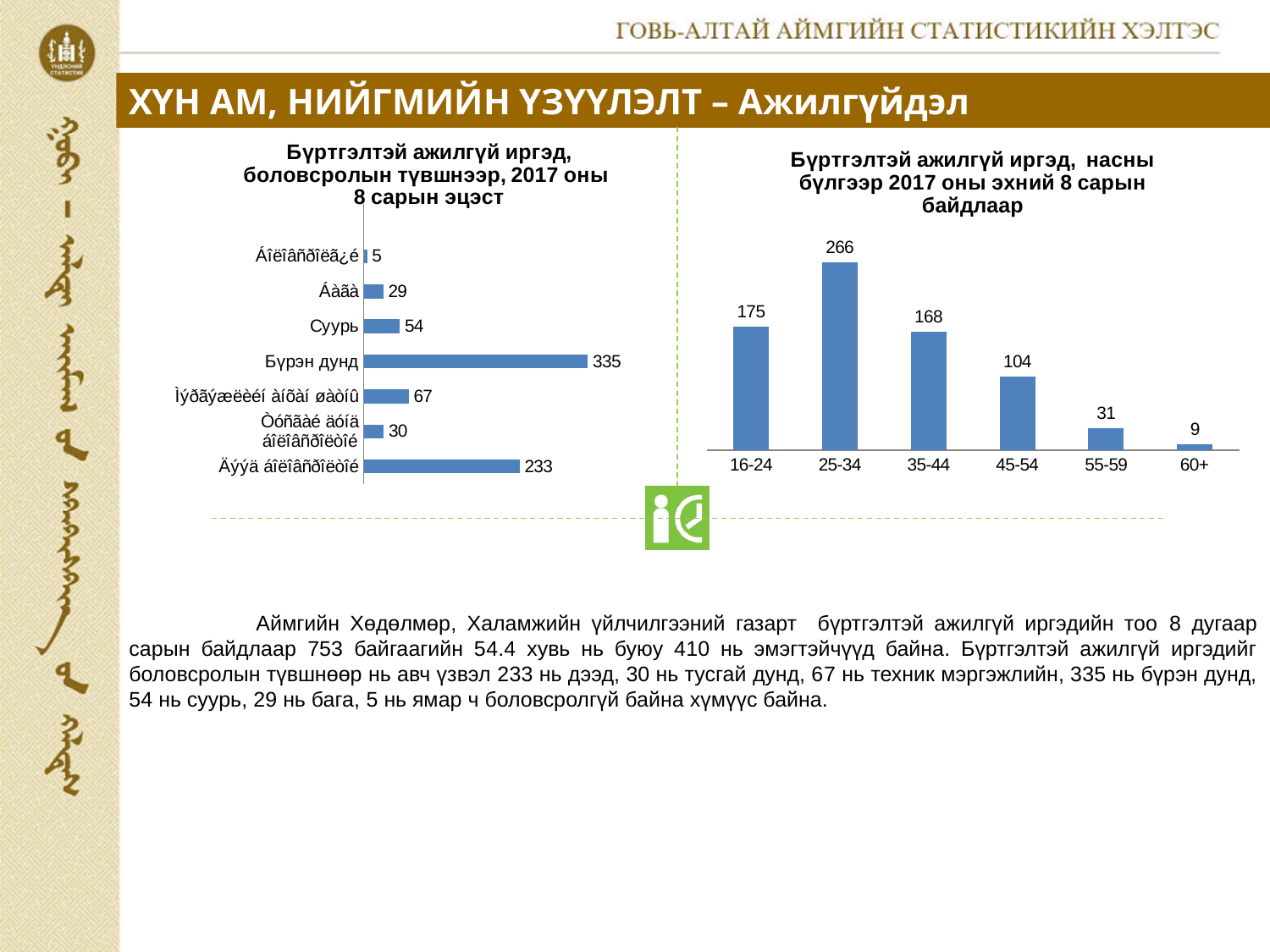
What type of chart is the left chart (by education level)? Bar chart In the right chart (by age group), what is the value for the 25-34 age group? 266 In the right chart (by age group), what is the difference between the values for 16-24 and 35-44? 7 In the right chart (by age group), how many age groups are shown? 6 In the right chart (by age group), what is the value for the 45-54 age group? 104 In the left chart (by education level), what is the value for Суурь? 54 In the left chart (by education level), how many categories are shown? 7 In the left chart (by education level), what is the value for Бүрэн дунд? 335 In the right chart (by age group), which age group has the lowest value? 60+ In the right chart (by age group), which is larger: the value for 16-24 or the value for 45-54? 16-24 In the right chart (by age group), which age group has the highest value? 25-34 In the right chart (by age group), what is the value for the 60+ age group? 9